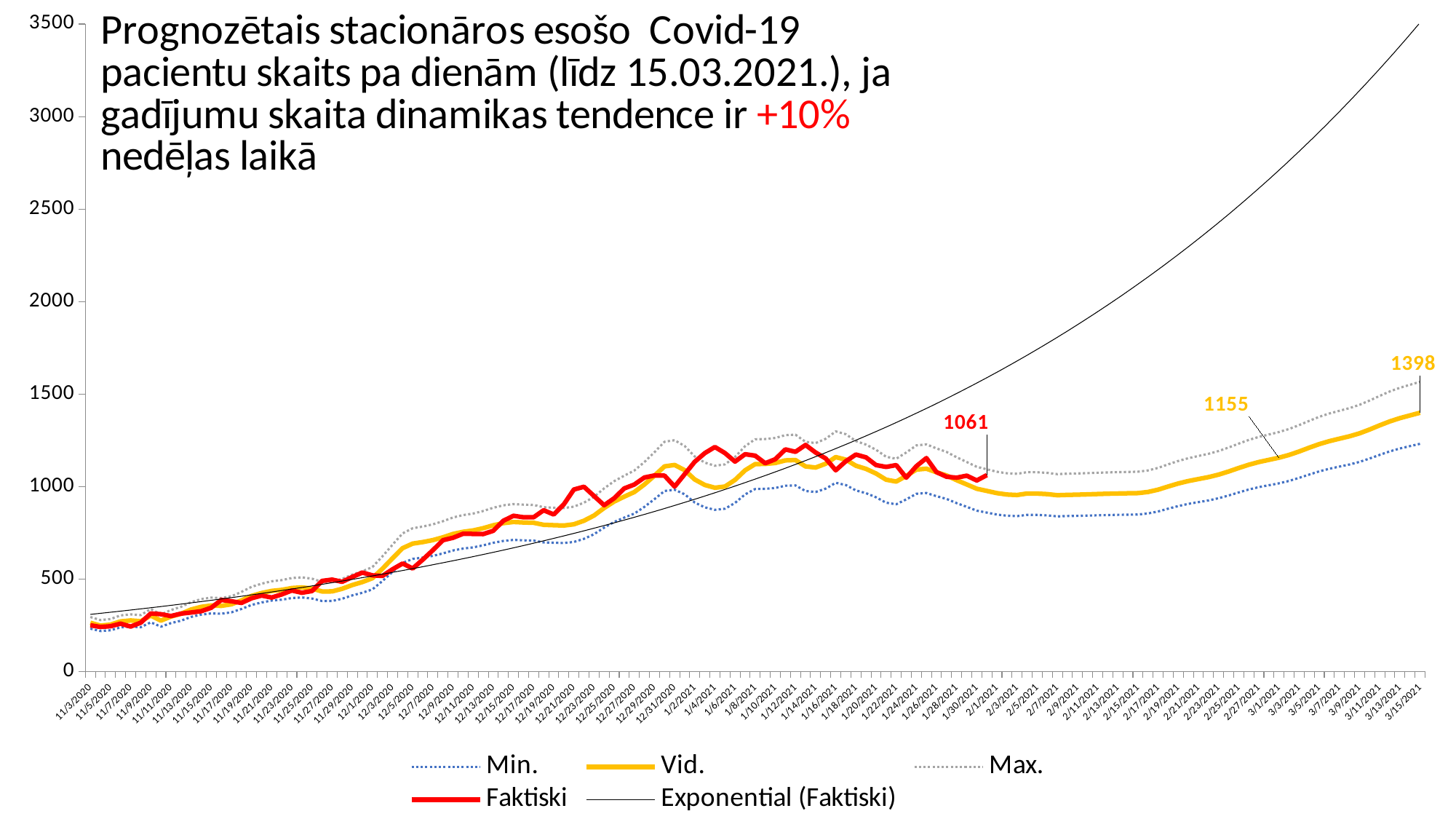
What is the labelled value at the end of the red Faktiski line? 1061 What kind of chart is shown on the slide? line chart Does the Exponential (Faktiski) line rise or fall along the x axis? rise What is the difference between the two labelled Vid. values, 1398 and 1155? 243 Is the value of the Exponential (Faktiski) line at 3/15/2021 greater or less than 3000? greater Which series reaches the highest value at 3/15/2021? Exponential (Faktiski) What value is labelled on the Vid. line between the 1061 and 1398 labels? 1155 Which is larger: the labelled end value of the Vid. line (1398) or the labelled end value of the Faktiski line (1061)? Vid. (1398) What colour is the Faktiski line? red Is the value of the Min. line at 3/15/2021 greater or less than 1500? less What is the labelled value at the end of the Vid. line on 3/15/2021? 1398 How many series does the legend list? 5